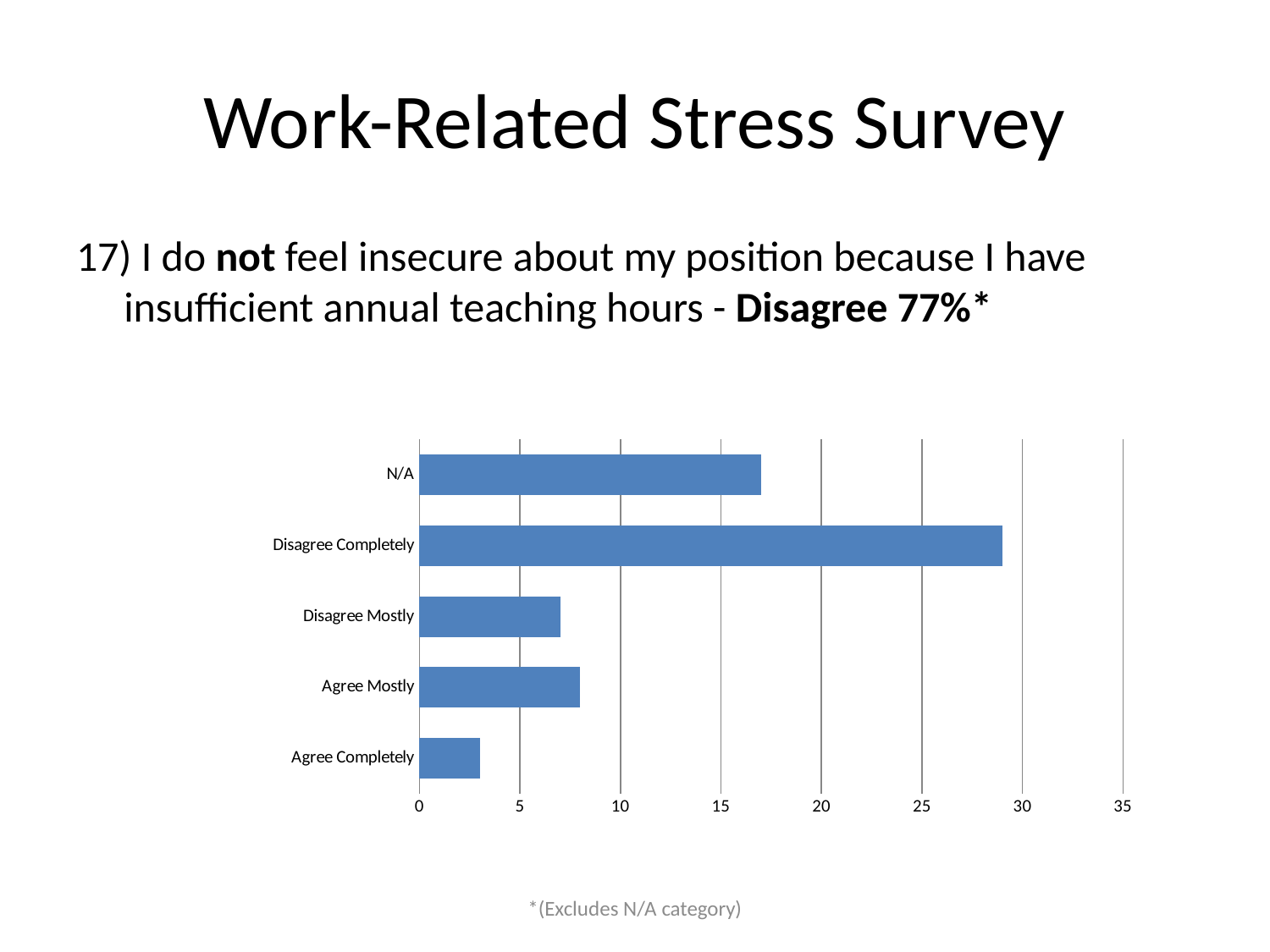
Is the value for Disagree Completely greater or less than 25? greater Is the value for N/A greater or less than 15? greater How many categories are shown on the chart? 5 What is the maximum value shown on the horizontal axis? 35 Which is larger, the value for Agree Mostly or the value for Agree Completely? Agree Mostly Which is larger, the value for Disagree Completely or the value for N/A? Disagree Completely What kind of chart is shown on the slide? bar chart Is the value for N/A greater or less than 20? less Which category has the highest value? Disagree Completely Which category has the lowest value? Agree Completely